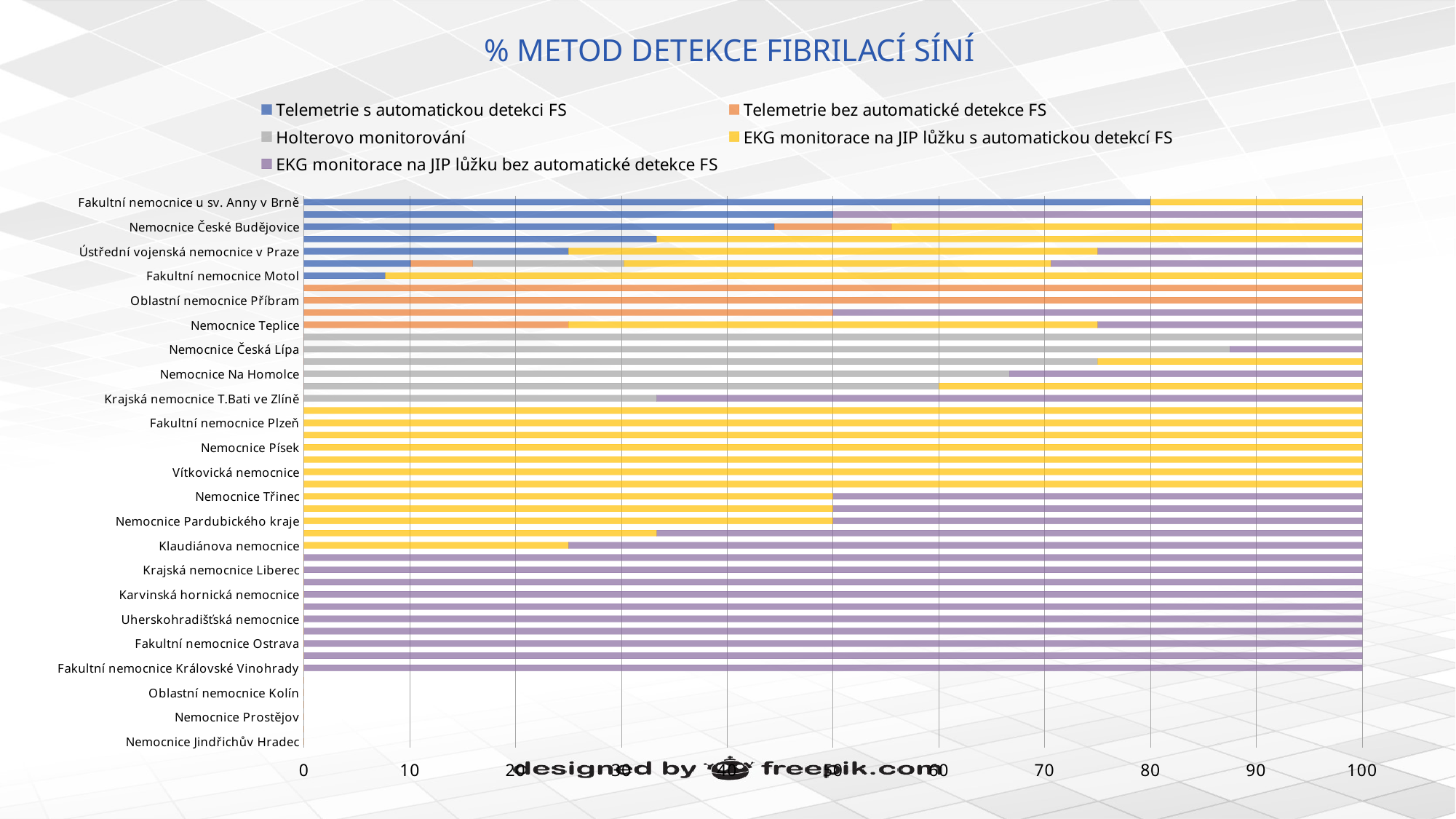
Which colour represents 'Holterovo monitorování' in the legend? gray How many series does the legend list? 5 Is the value of 'Telemetrie s automatickou detekci FS' for Fakultní nemocnice Motol greater or less than 10? less What kind of chart is shown on the slide? bar chart What is the value of 'EKG monitorace na JIP lůžku s automatickou detekcí FS' for Nemocnice Třinec? 50 What is the value of 'Telemetrie s automatickou detekci FS' for Fakultní nemocnice u sv. Anny v Brně? 80 What is the value of 'Telemetrie bez automatické detekce FS' for Oblastní nemocnice Příbram? 100 Is the value of 'Holterovo monitorování' for Nemocnice Na Homolce greater or less than 60? greater Which has a larger value for 'Telemetrie s automatickou detekci FS': Ústřední vojenská nemocnice v Praze or Fakultní nemocnice Motol? Ústřední vojenská nemocnice v Praze Is the value of 'Holterovo monitorování' for Krajská nemocnice T.Bati ve Zlíně greater or less than 40? less What is the title of the chart? % METOD DETEKCE FIBRILACÍ SÍNÍ